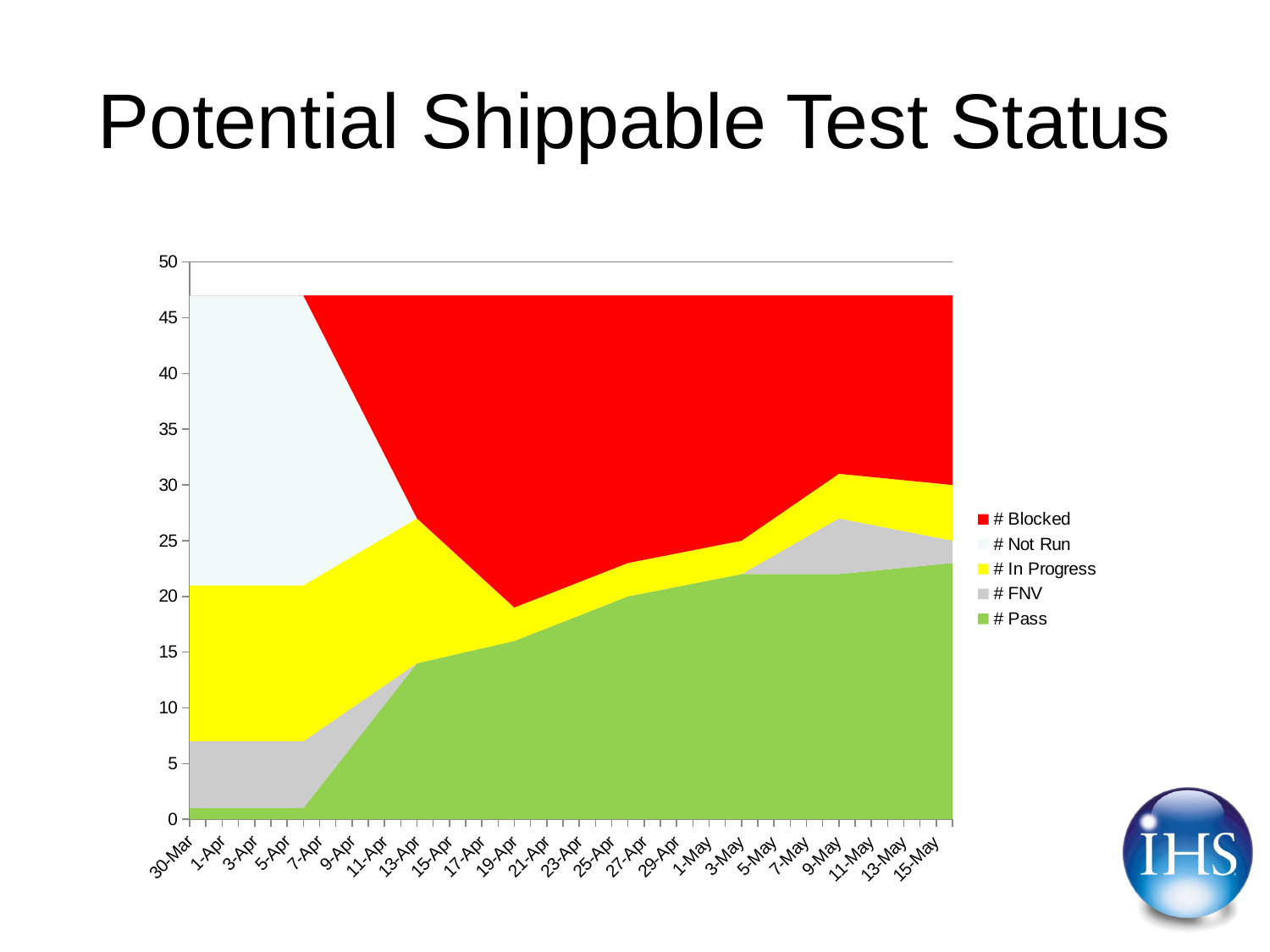
Is the value for # Pass on 30-Mar greater or less than 5? less Which series is shown in red in the chart? # Blocked Is the top of the stacked total on 15-May greater or less than 50? less How many series does the legend list? 5 Which series is larger on 30-Mar, # Not Run or # Pass? # Not Run Which series is larger on 15-May, # Blocked or # FNV? # Blocked Does the # Pass area rise or fall from 30-Mar to 15-May? Rise What is the highest value shown on the y axis? 50 Is the value for # Pass on 13-Apr greater or less than 10? greater What is the title of the slide? Potential Shippable Test Status What kind of chart is shown on the slide? Stacked area chart